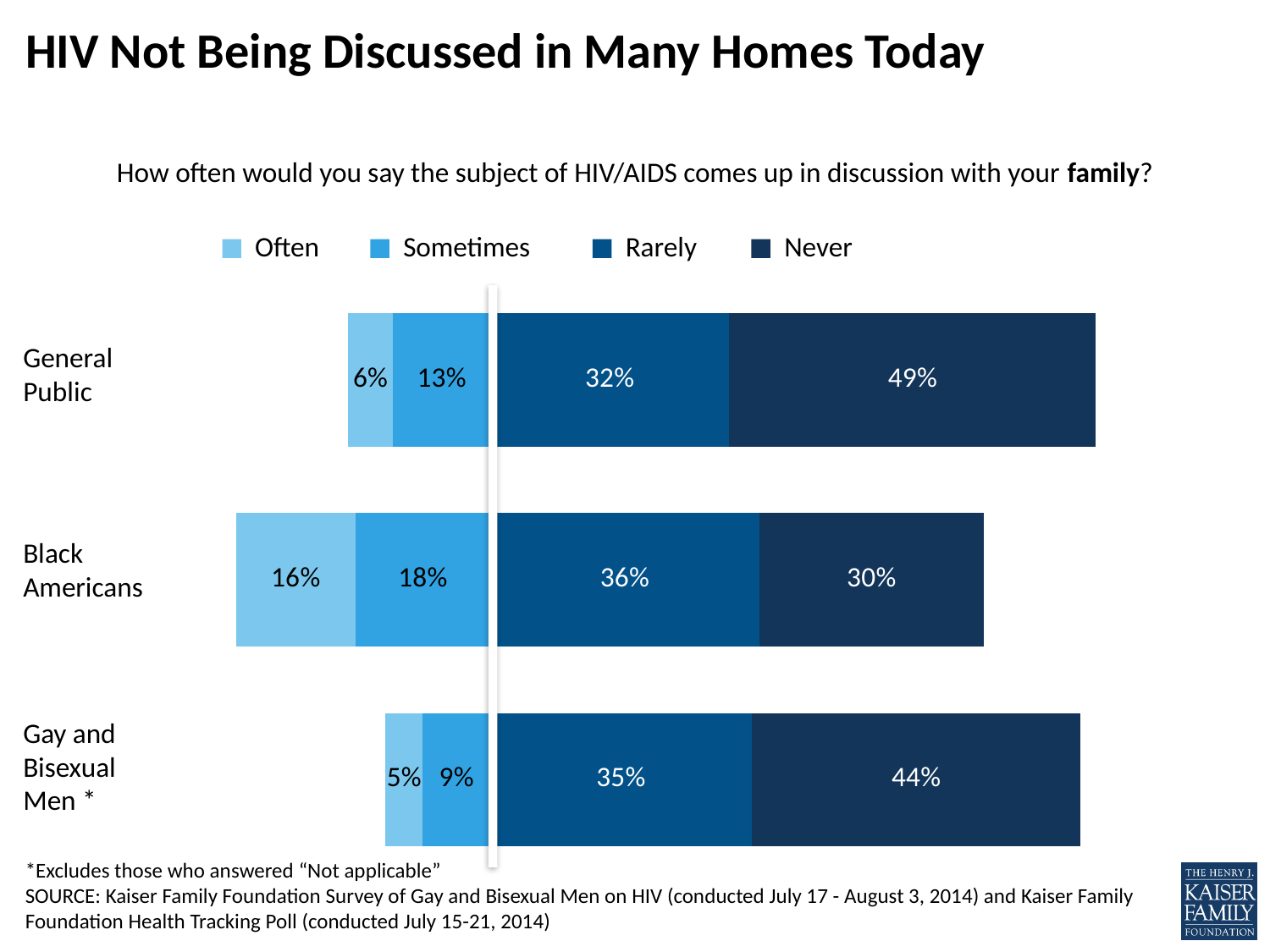
Which is larger: the 'Rarely' share for Black Americans or for the General Public? Black Americans What percentage of Gay and Bisexual Men said 'Sometimes'? 9% How many groups are shown in the chart? 3 What is the difference between the 'Never' share for the General Public and for Black Americans? 19 percentage points What type of chart is shown on the slide? Stacked bar chart How many response categories does the legend list? 4 Which group has the lowest share answering 'Often'? Gay and Bisexual Men Which group has the highest share answering 'Never'? General Public What percentage of the General Public said HIV/AIDS comes up 'Never' in discussion with their family? 49% What percentage of Black Americans said HIV/AIDS comes up 'Often' in discussion with their family? 16% What percentage of Gay and Bisexual Men said HIV/AIDS comes up 'Rarely' in discussion with their family? 35% What is the combined total of 'Rarely' and 'Never' for Gay and Bisexual Men? 79%